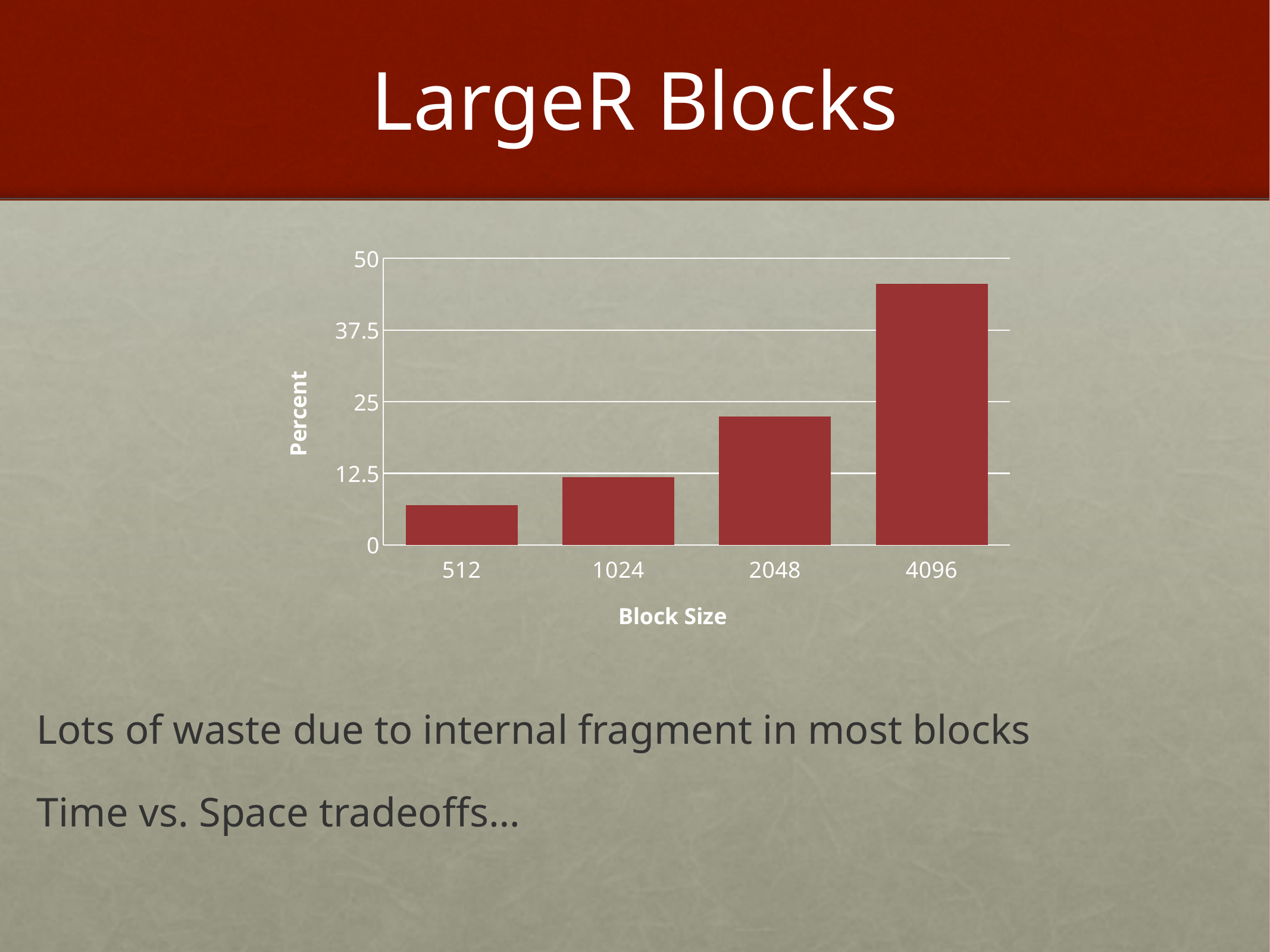
How many block sizes are plotted on the chart? 4 What kind of chart is shown on the slide? bar chart Is the value for block size 4096 greater or less than 50? less What is the label on the vertical axis of the chart? Percent Is the value for block size 512 greater or less than 12.5? less Is the value for block size 2048 greater or less than 25? less Which block size has the highest percent? 4096 Which block size has the lowest percent? 512 Which has a larger percent, block size 1024 or block size 2048? 2048 Do the values rise or fall as block size increases along the x axis? rise